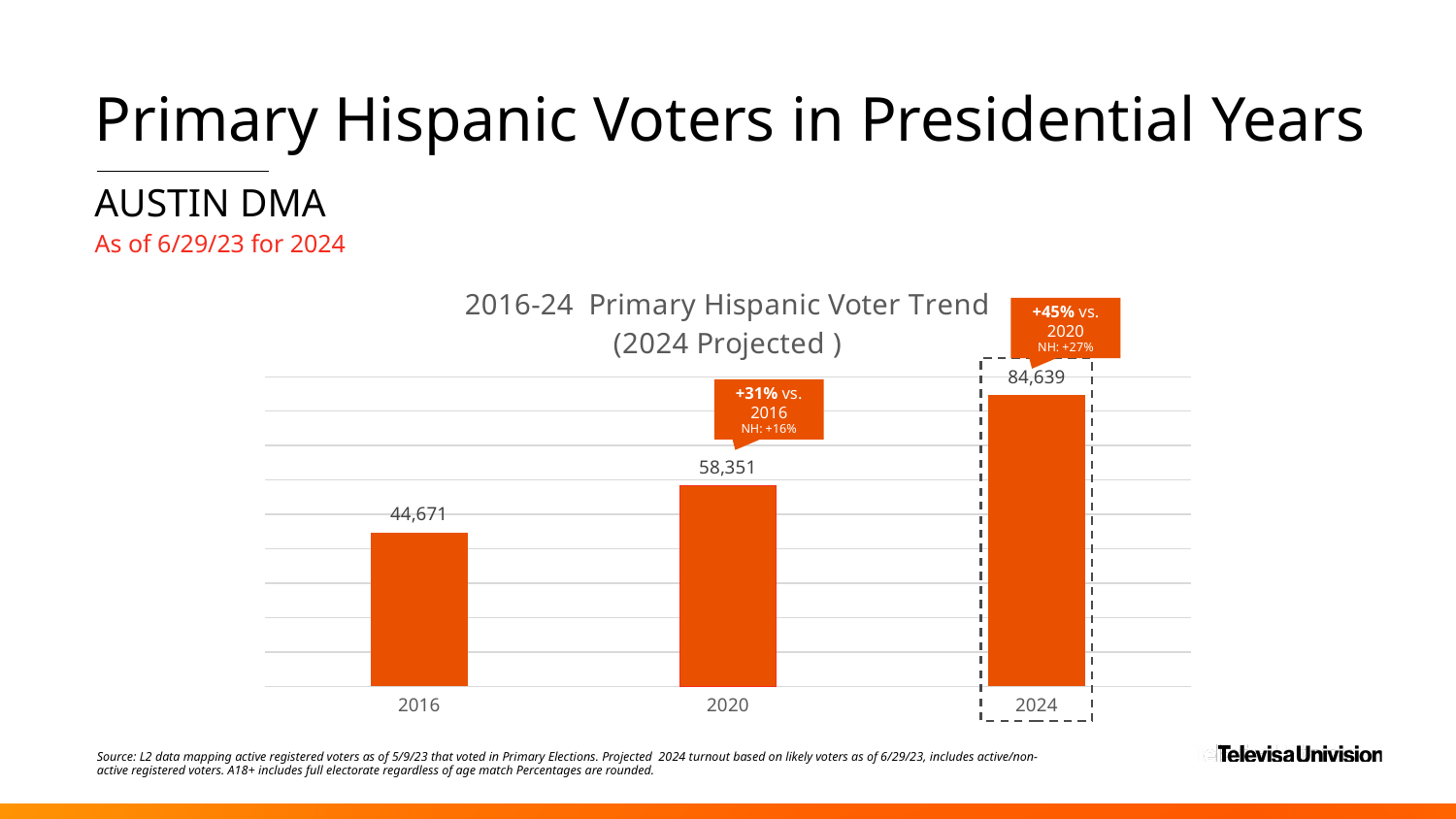
Do the values rise or fall from 2016 to 2024? Rise What is the difference between the 2020 and 2016 values? 13,680 What kind of chart is shown? Bar chart Which is larger, the value for 2020 or the value for 2016? 2020 What is the title of the chart? 2016-24 Primary Hispanic Voter Trend (2024 Projected) How many years are plotted on the chart? 3 What is the difference between the 2024 and 2020 values? 26,288 What is the value for 2016? 44,671 Which year has the lowest value? 2016 What is the projected value for 2024? 84,639 What is the value for 2020? 58,351 Which year has the highest value? 2024